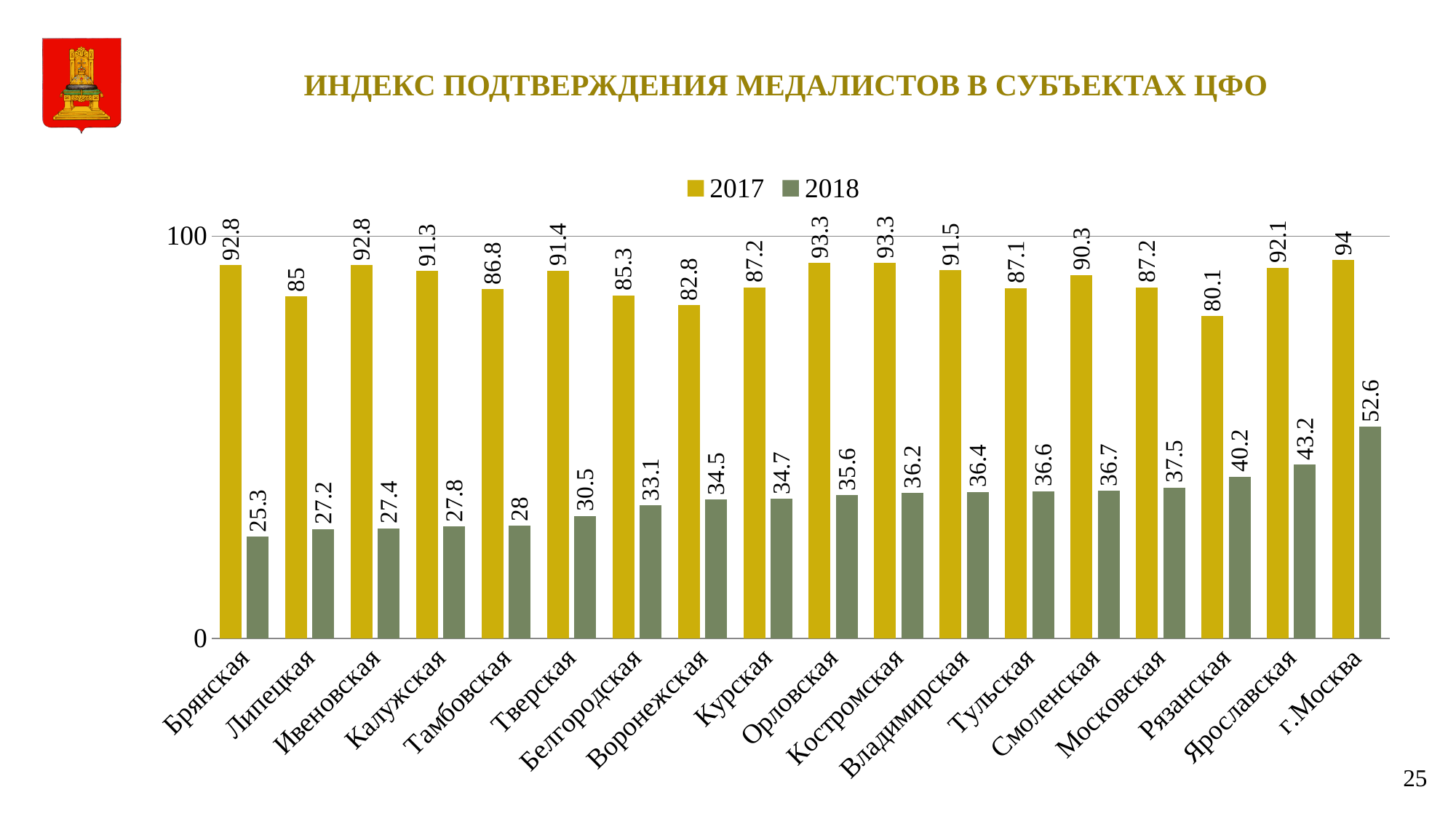
Which region has the lowest 2018 value? Брянская What is the difference between the 2017 and 2018 values for г.Москва? 41.4 What is the 2018 value for г.Москва? 52.6 What is the difference between the 2017 and 2018 values for Брянская? 67.5 Which region has the lowest 2017 value? Рязанская Which is larger: the 2018 value for Ярославская or the 2018 value for Рязанская? Ярославская Do the 2018 values rise or fall from left to right along the x axis? rise What is the 2018 value for Тамбовская? 28 Which region has the highest 2017 value? г.Москва How many series does the legend list? 2 What is the 2017 value for Брянская? 92.8 How many regions are shown on the x axis? 18